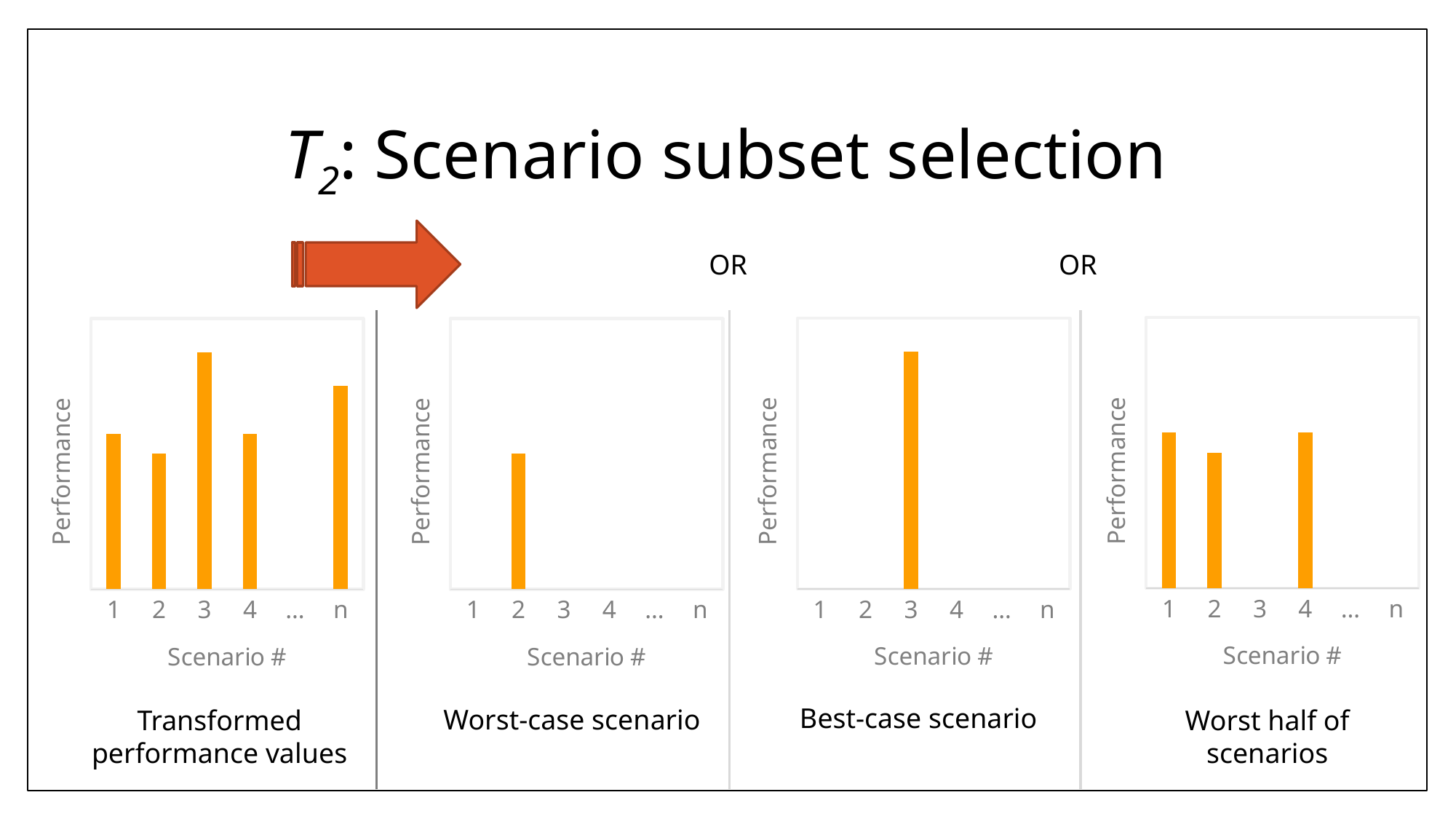
In the 'Worst-case scenario' chart, which scenario number has a bar plotted? 2 What is the x-axis label of the 'Transformed performance values' chart? Scenario # In the 'Transformed performance values' chart, which scenario has the highest performance bar? 3 In the 'Transformed performance values' chart, which bar is taller: scenario 2 or scenario n? Scenario n How many bars are plotted in the 'Worst half of scenarios' chart? 3 How many bars are plotted in the 'Worst-case scenario' chart? 1 In the 'Worst half of scenarios' chart, which scenario has the lowest bar? 2 In the 'Transformed performance values' chart, which bar is taller: scenario 3 or scenario n? Scenario 3 In the 'Transformed performance values' chart, which scenario has the lowest performance bar? 2 How many bars are plotted in the 'Transformed performance values' chart? 5 In the 'Best-case scenario' chart, which scenario number has a bar plotted? 3 What kind of chart is the 'Best-case scenario' chart? Bar chart